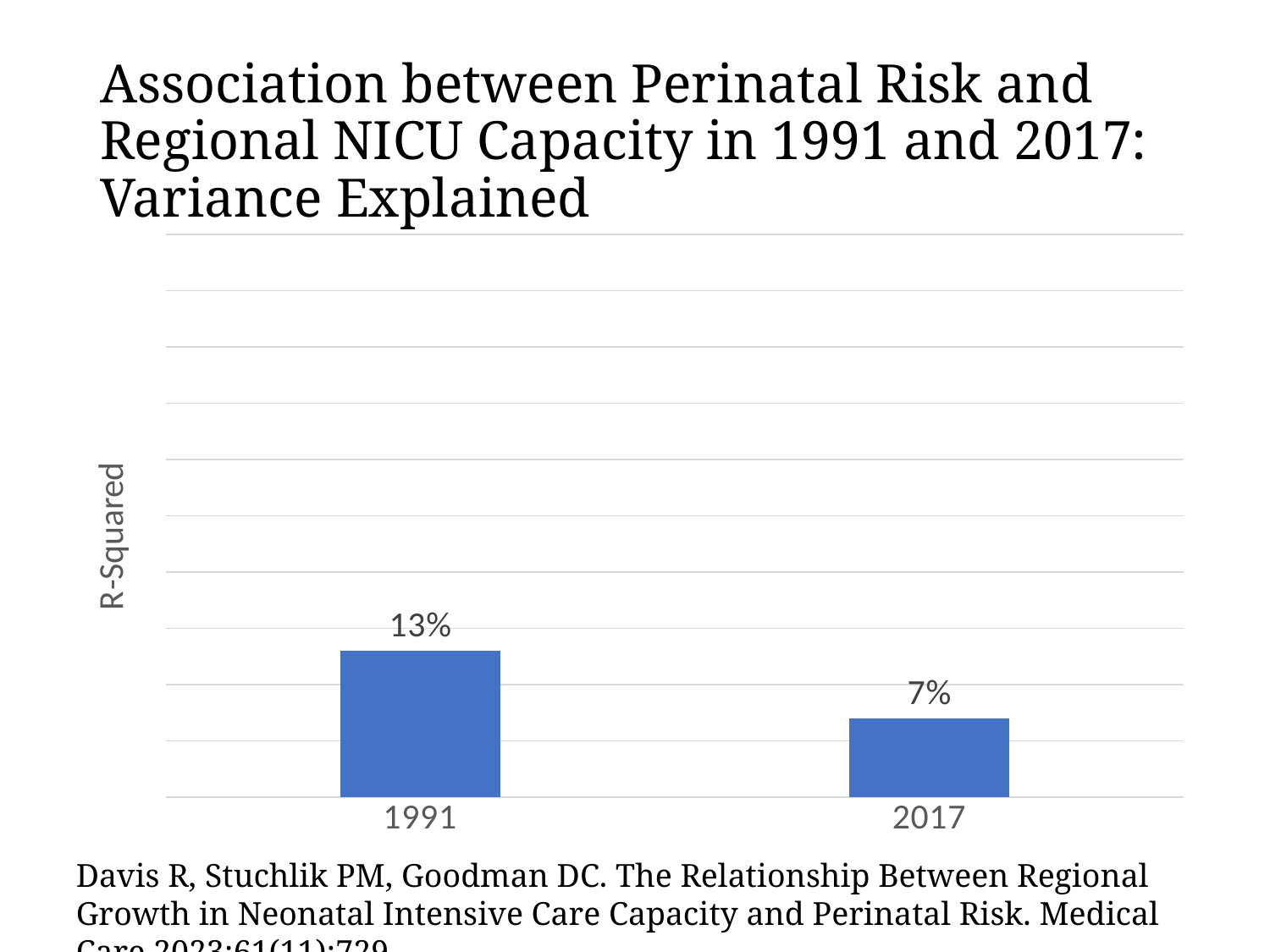
What is the R-Squared value for 2017? 7% Is the R-Squared value for 2017 larger or smaller than the value for 1991? smaller What is the R-Squared value for 1991? 13% What is the label on the vertical axis of the chart? R-Squared What kind of chart is shown on the slide? bar chart Which year has the lower R-Squared value? 2017 How many years are shown on the x axis of the chart? 2 Which year has the higher R-Squared value? 1991 What is the difference between the R-Squared values for 1991 and 2017? 6% Do the values rise or fall from 1991 to 2017? fall What colour are the bars in the chart? blue